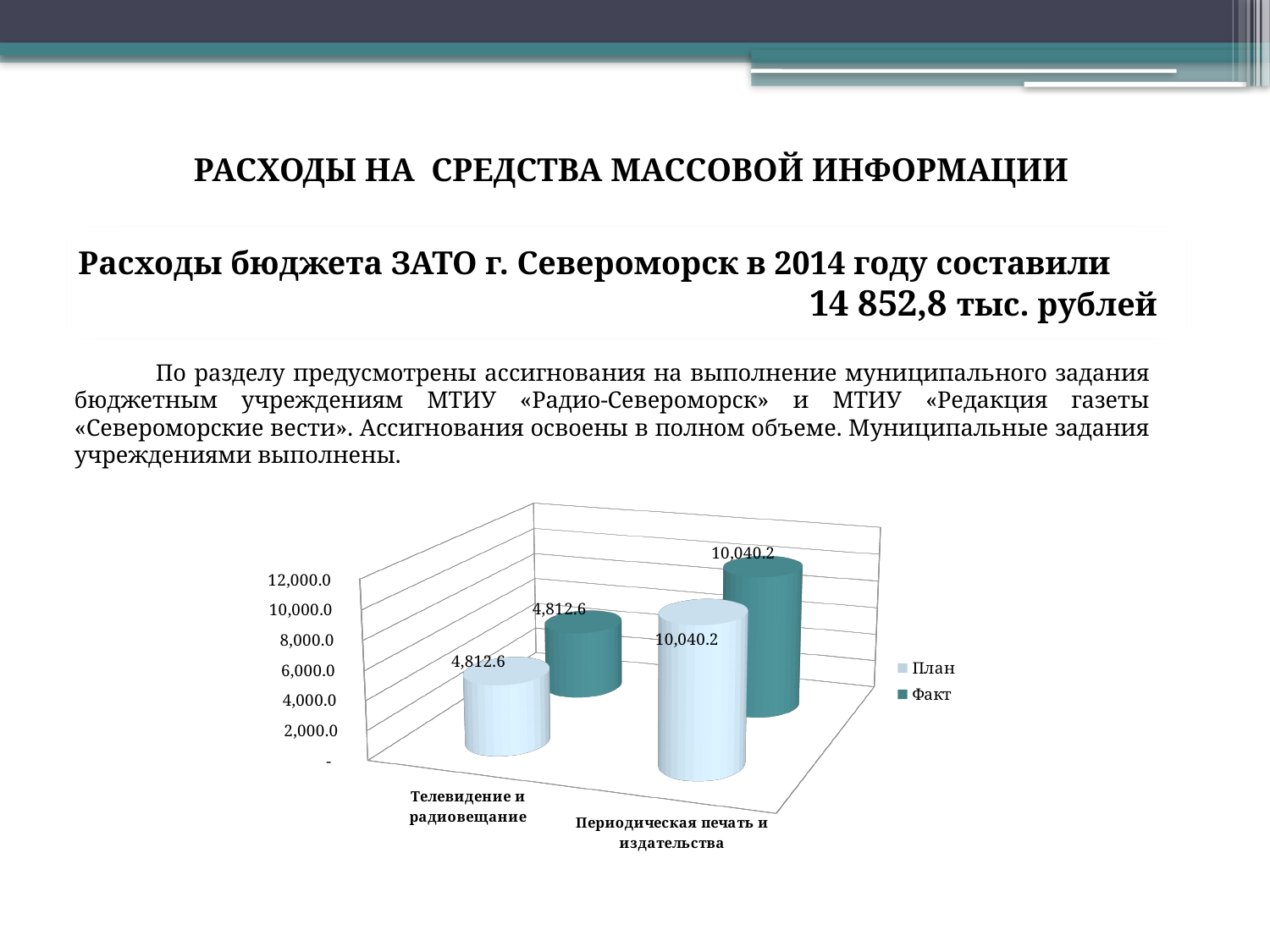
How many series does the chart legend list? 2 How many categories are shown on the chart? 2 What is the Факт value for Телевидение и радиовещание? 4,812.6 What is the Факт value for Периодическая печать и издательства? 10,040.2 Which category has the highest Факт value? Периодическая печать и издательства What is the difference between the План values for Периодическая печать и издательства and Телевидение и радиовещание? 5,227.6 What kind of chart is shown on the slide? bar chart Which category has the lowest План value? Телевидение и радиовещание Which is larger: the Факт value for Телевидение и радиовещание or the Факт value for Периодическая печать и издательства? Периодическая печать и издательства What is the План value for Телевидение и радиовещание? 4,812.6 Is the План value for Периодическая печать и издательства greater or less than 8,000.0? greater What is the План value for Периодическая печать и издательства? 10,040.2